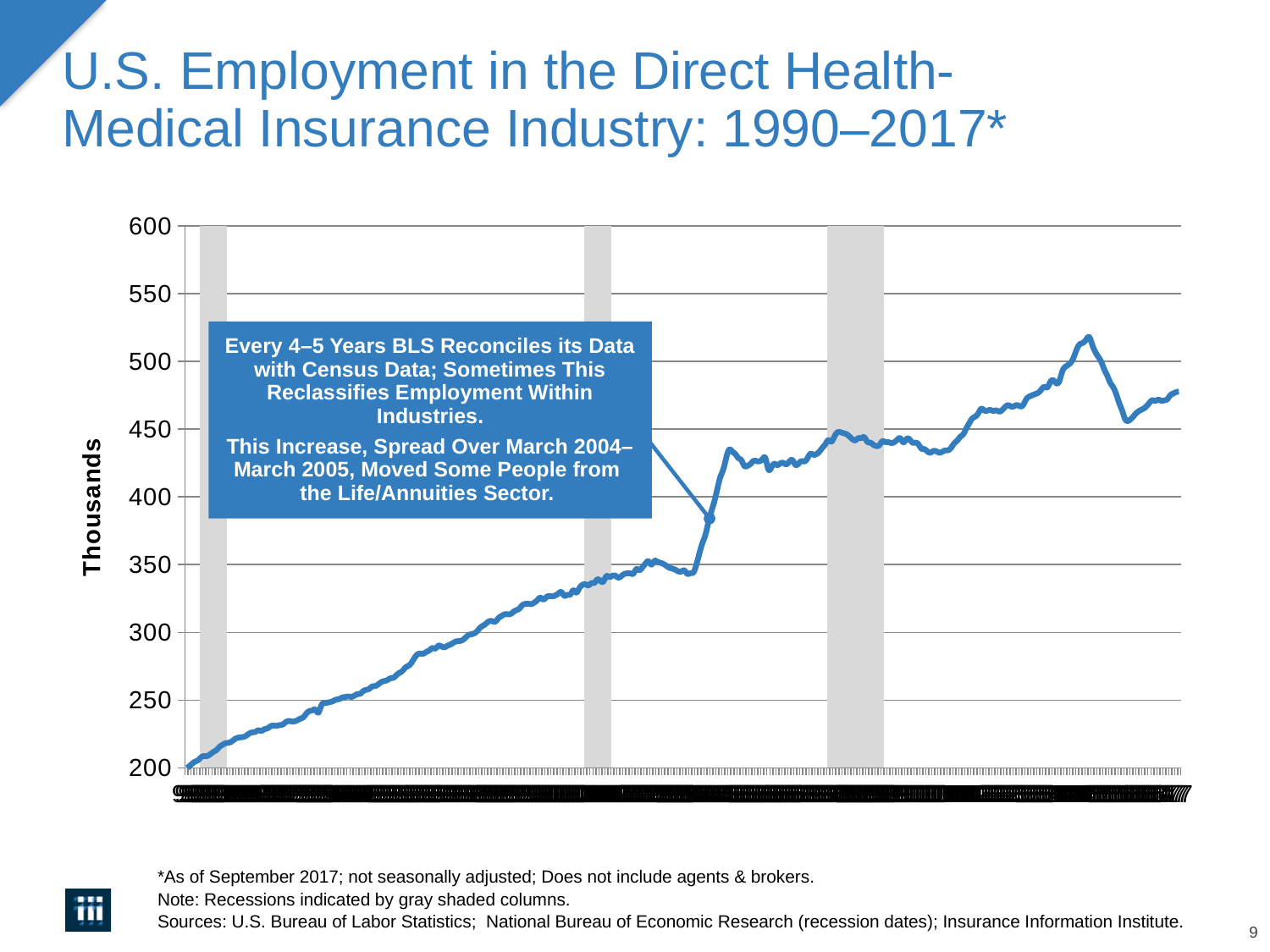
Is the value at the start of the series (left end of the line) greater or less than 250? less What is the label on the vertical axis of the chart? Thousands What kind of chart is shown on the slide? Line chart Is the value at the end of the series (right end of the line) greater or less than 450? greater How many data series are plotted on the chart? 1 What is the highest value shown on the vertical axis of the chart? 600 What is the title of the chart on the slide? U.S. Employment in the Direct Health-Medical Insurance Industry: 1990–2017* Is the highest point reached by the line greater or less than 550? less Overall, do the values rise or fall from the left to the right of the chart? Rise Which is larger: the value at the start of the series or the value at the end of the series? The value at the end of the series